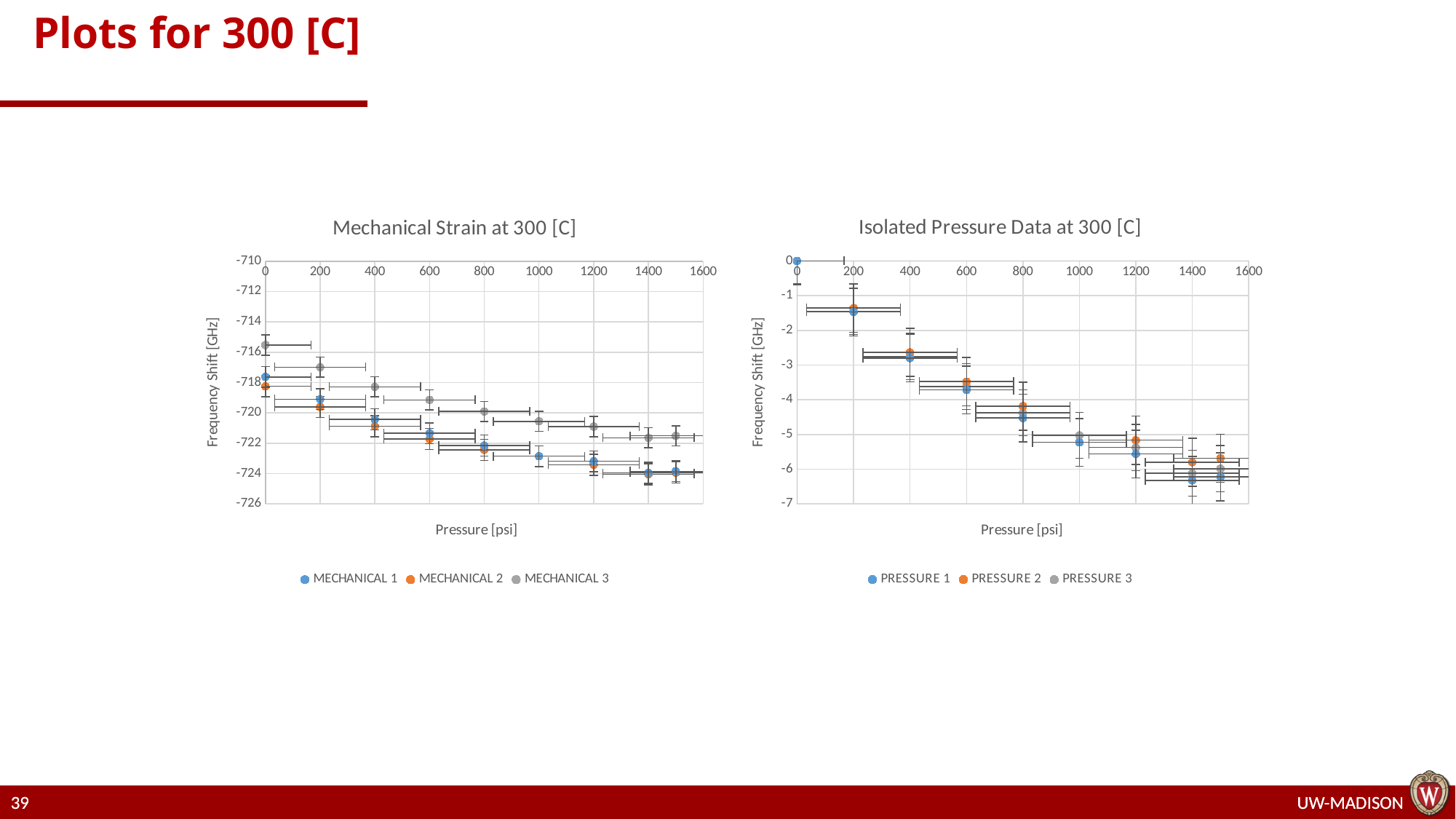
How many series does the legend of the 'Isolated Pressure Data at 300 [C]' chart list? 3 What kind of chart is the 'Mechanical Strain at 300 [C]' chart? scatter chart In the 'Mechanical Strain at 300 [C]' chart, is the value for MECHANICAL 3 at 200 psi greater or less than -718? greater What is the y-axis label of the 'Mechanical Strain at 300 [C]' chart? Frequency Shift [GHz] In the 'Isolated Pressure Data at 300 [C]' chart, is the value for PRESSURE 2 at 800 psi greater or less than -4? less In the 'Isolated Pressure Data at 300 [C]' chart, do the values rise or fall as pressure increases? fall In the 'Isolated Pressure Data at 300 [C]' chart, at 1400 psi, which is larger: PRESSURE 1 or PRESSURE 2? PRESSURE 2 In the 'Mechanical Strain at 300 [C]' chart, which series has the highest value at 0 psi? MECHANICAL 3 In the 'Isolated Pressure Data at 300 [C]' chart, what is the value for PRESSURE 1 at 0 psi? 0 In the 'Isolated Pressure Data at 300 [C]' chart, is the value for PRESSURE 1 at 200 psi greater or less than -1? less In the 'Mechanical Strain at 300 [C]' chart, do the frequency shift values rise or fall as pressure increases? fall